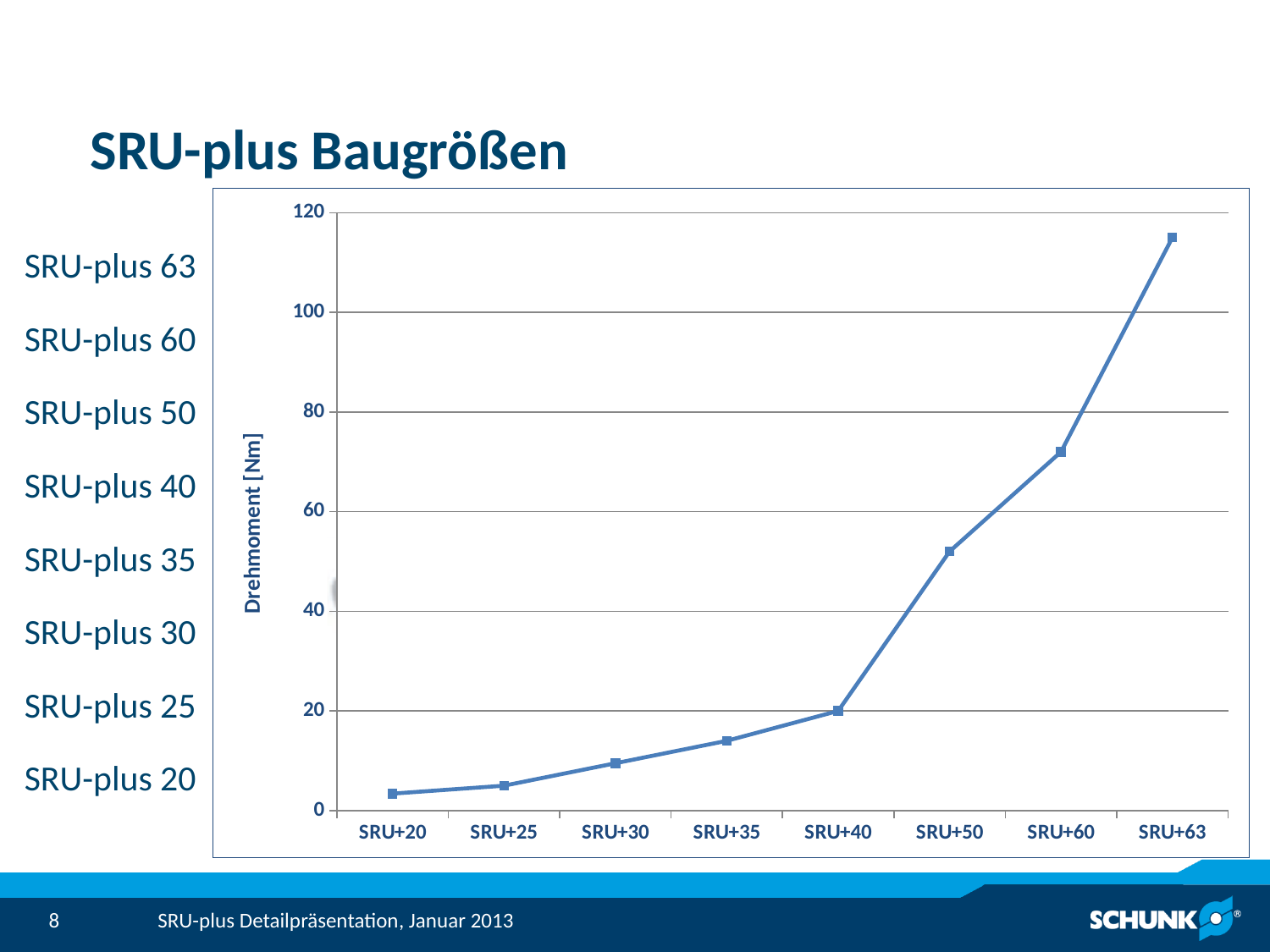
Is the value for SRU+50 greater or less than 40? greater Is the value for SRU+63 greater or less than 100? greater Do the values rise or fall from SRU+20 to SRU+63? rise Which has the larger Drehmoment, SRU+50 or SRU+40? SRU+50 How many SRU sizes are plotted along the x axis? 8 Which size has the lowest Drehmoment? SRU+20 Which size has the highest Drehmoment? SRU+63 What is the label of the y axis? Drehmoment [Nm] What kind of chart is shown on the slide? line chart Is the value for SRU+35 greater or less than 20? less What is the title of the slide? SRU-plus Baugrößen